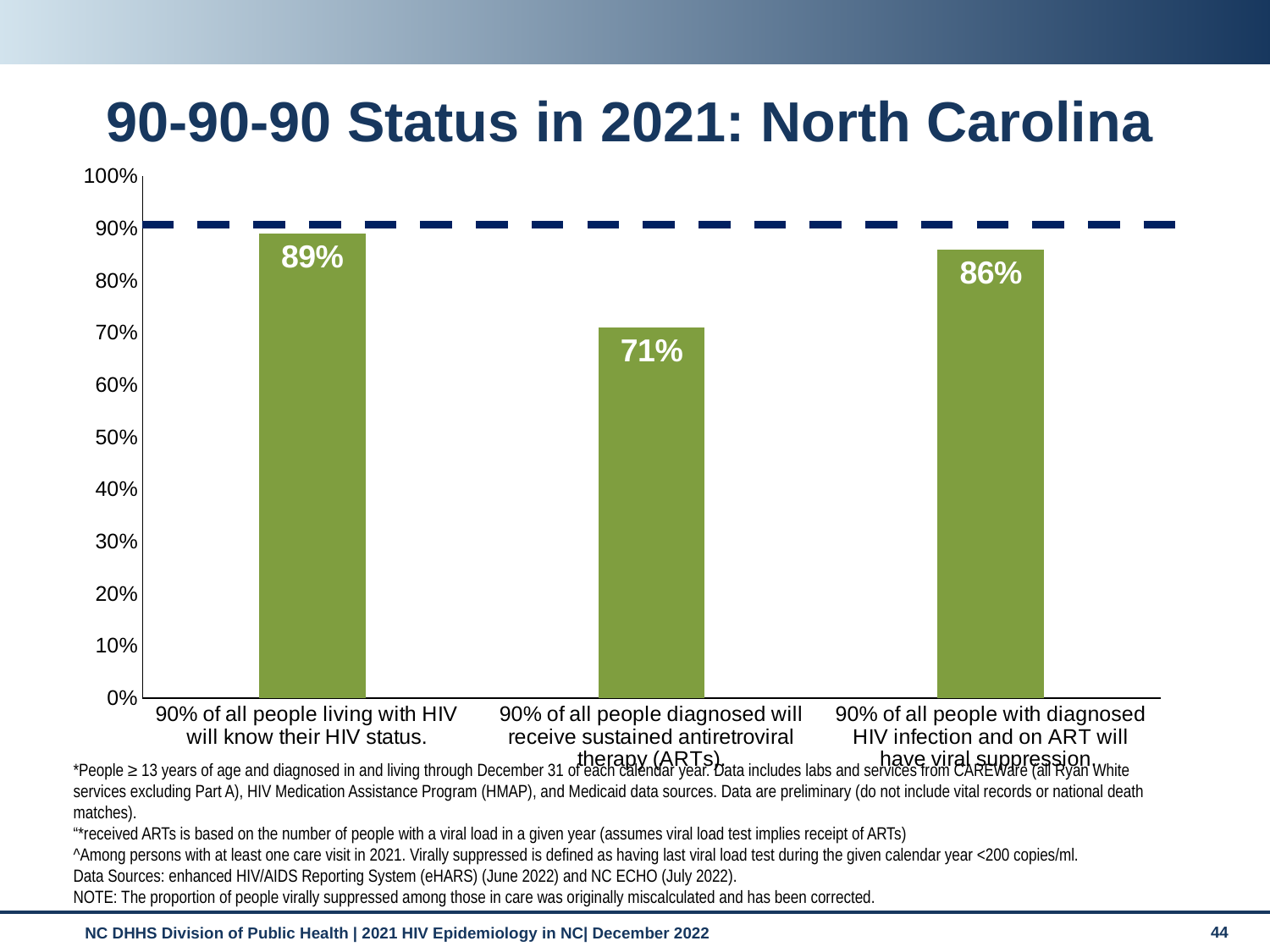
Which category has the highest value? 90% of all people living with HIV will know their HIV status. Is the value for receiving sustained ARTs greater or less than 80%? less What percentage of all people with diagnosed HIV infection and on ART have viral suppression? 86% Which is larger: the value for knowing HIV status or the value for viral suppression? Knowing HIV status (89%) What kind of chart is shown on the slide? Bar chart At what level is the dashed horizontal line drawn on the chart? 90% Which category has the lowest value? 90% of all people diagnosed will receive sustained antiretroviral therapy (ARTs). What percentage of all people diagnosed receive sustained antiretroviral therapy (ARTs)? 71% What is the difference between the value for viral suppression and the value for receiving sustained ARTs? 15% What percentage of all people living with HIV know their HIV status? 89% How many bars are shown in the chart? 3 What is the difference between the value for knowing HIV status and the value for receiving sustained ARTs? 18%